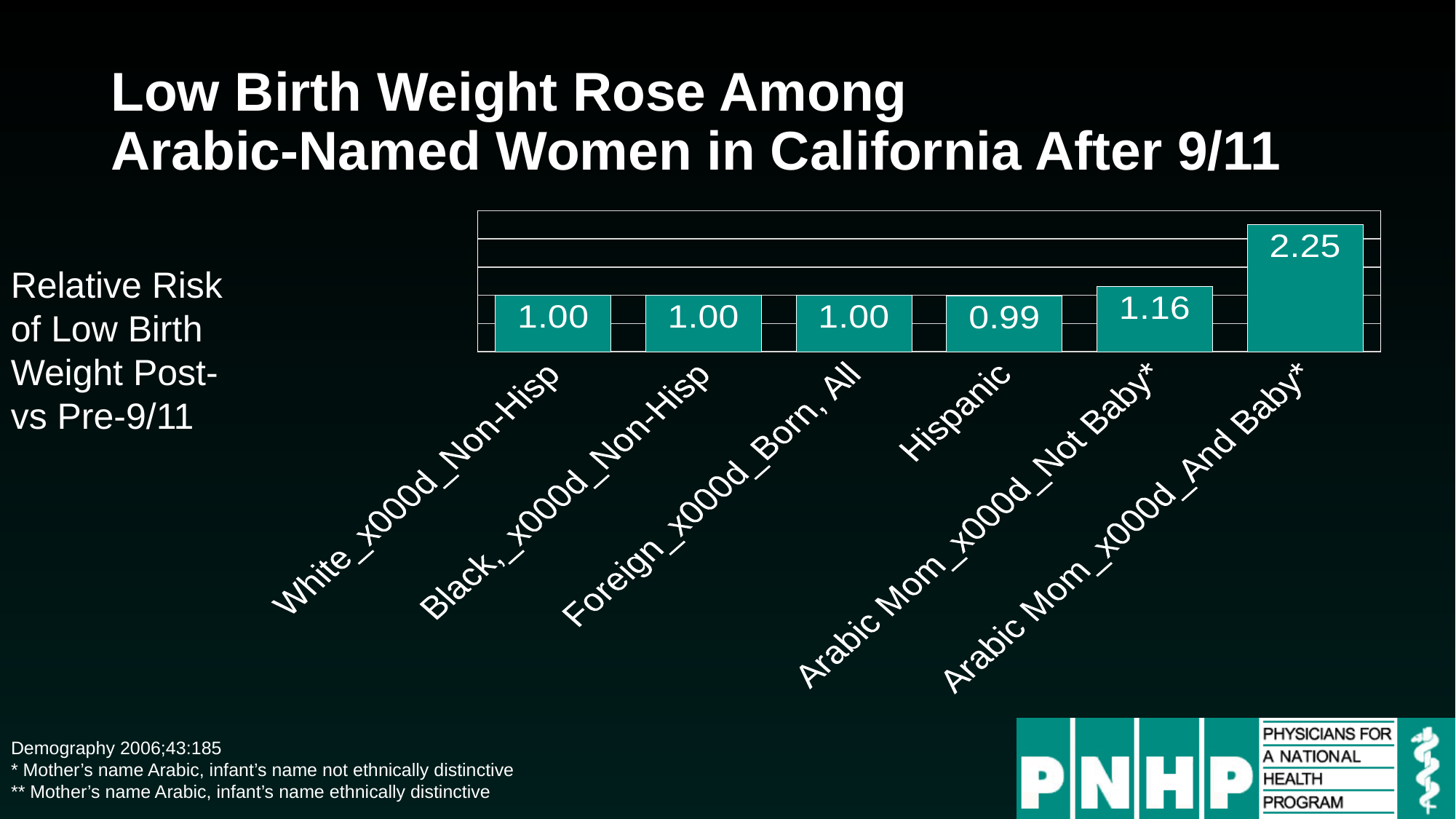
What is the relative risk value shown for the Arabic Mom And Baby bar? 2.25 Which category has the highest relative risk of low birth weight? Arabic Mom And Baby How many categories are plotted in the chart? 6 What type of chart is shown on the slide? Bar chart What is the relative risk value shown for the Arabic Mom Not Baby bar? 1.16 Which category has the lowest relative risk of low birth weight? Hispanic What is the difference between the relative risk for Arabic Mom Not Baby and Hispanic? 0.17 Which is larger, the relative risk for Arabic Mom Not Baby or for Foreign Born, All? Arabic Mom Not Baby What is the difference between the relative risk for Arabic Mom And Baby and Arabic Mom Not Baby? 1.09 What is the relative risk value shown for the Hispanic bar? 0.99 What is the relative risk value shown for the White Non-Hisp bar? 1.00 What colour are the bars in the chart? Teal